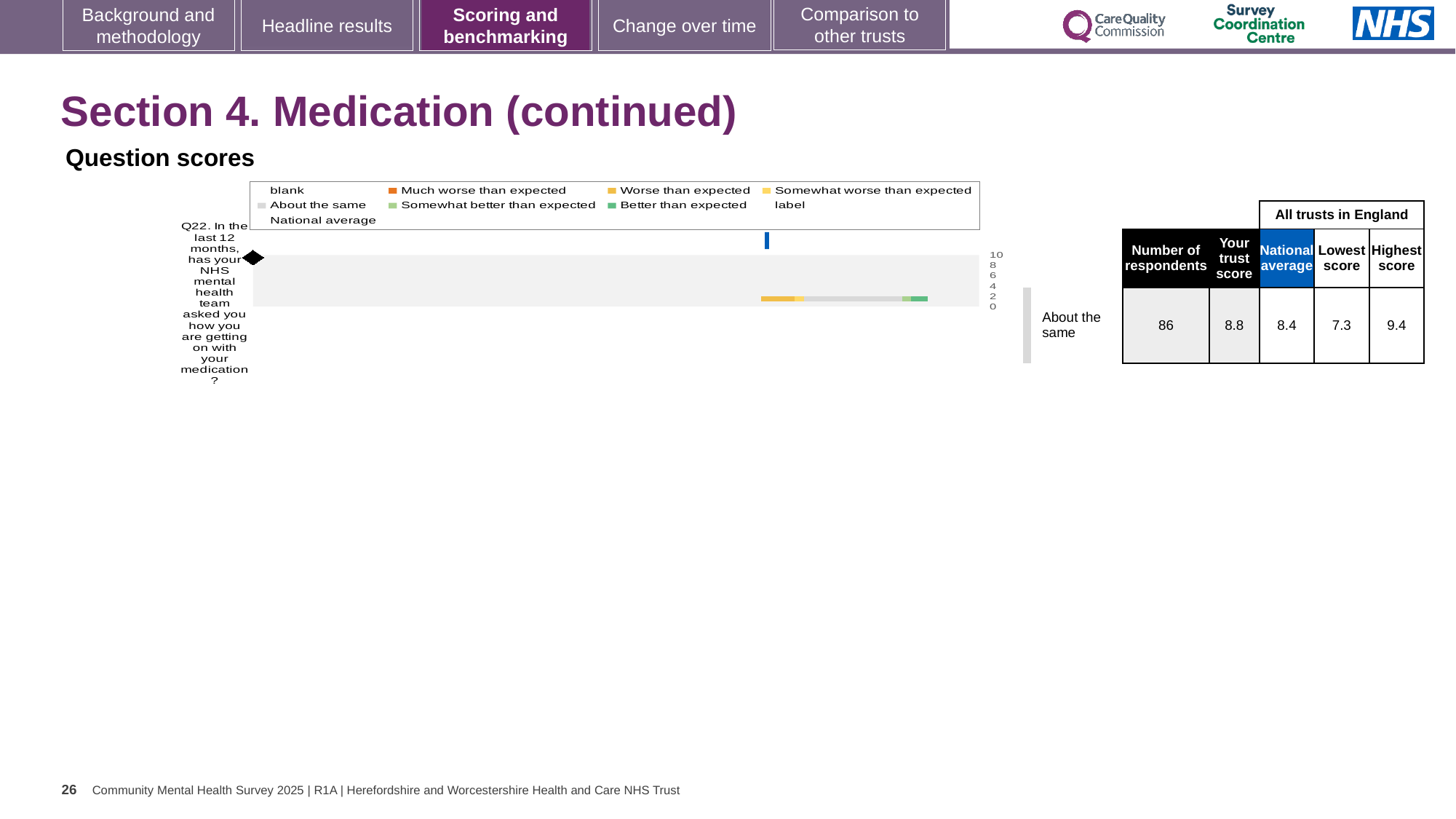
How many respondents answered Q22? 86 What is the national average for Q22 shown in the table beside the chart? 8.4 How many survey questions are plotted in the Question scores chart? 1 Which legend entry is shown in dark green in the Question scores chart? Better than expected What is the difference between the highest score and the lowest score for Q22? 2.1 Which is larger for Q22, the trust score or the national average? trust score What benchmark category is shown next to the Q22 bar? About the same What kind of chart is used to show the Q22 question score? bar chart What is the lowest score among all trusts in England for Q22? 7.3 Which question is plotted in the Question scores chart? Q22. In the last 12 months, has your NHS mental health team asked you how you are getting on with your medication? What is the trust score for Q22 shown in the table beside the chart? 8.8 What is the highest score among all trusts in England for Q22? 9.4